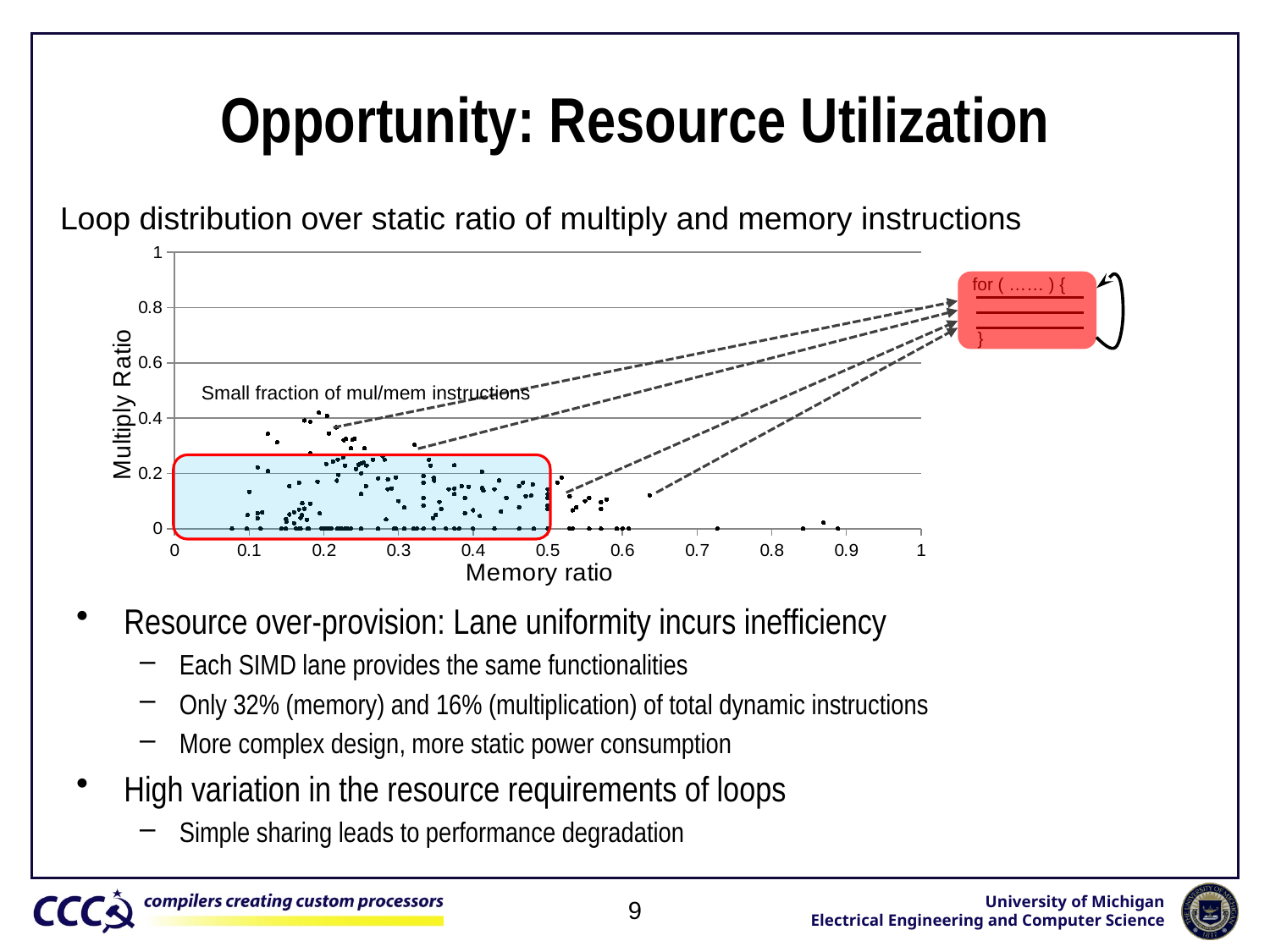
What is the label of the vertical axis of the chart? Multiply Ratio What is the label of the horizontal axis of the chart? Memory ratio Is the Multiply Ratio of the point with the largest Memory ratio greater or less than 0.2? less Is the highest Multiply Ratio among the plotted points greater or less than 0.8? less What kind of chart is shown on the slide? scatter chart Is the largest Memory ratio among the plotted points greater or less than 0.8? greater